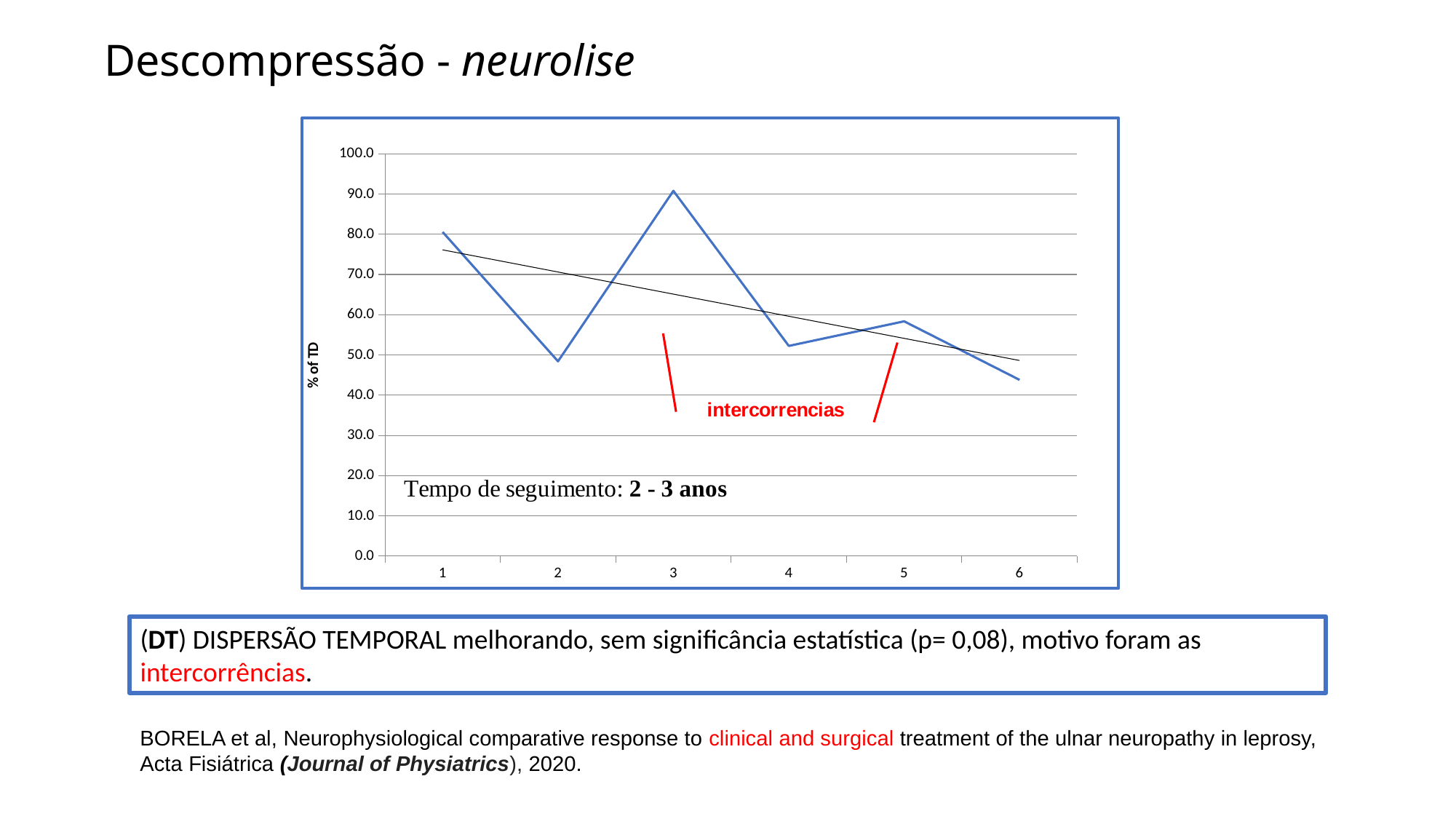
Which has the larger value, point 1 or point 2? point 1 What kind of chart is shown on the slide? line chart How many points are plotted along the x axis of the chart? 6 Does the black trend line rise or fall from point 1 to point 6? fall Which has the larger value, point 3 or point 4? point 3 What red annotation word is written inside the chart area? intercorrencias Is the value at point 3 greater or less than 80? greater Is the value at point 6 greater or less than 50? less Is the value at point 1 greater or less than 70? greater At which x-axis point does the blue line reach its highest value? 3 What is the label on the y axis of the chart? % of TD